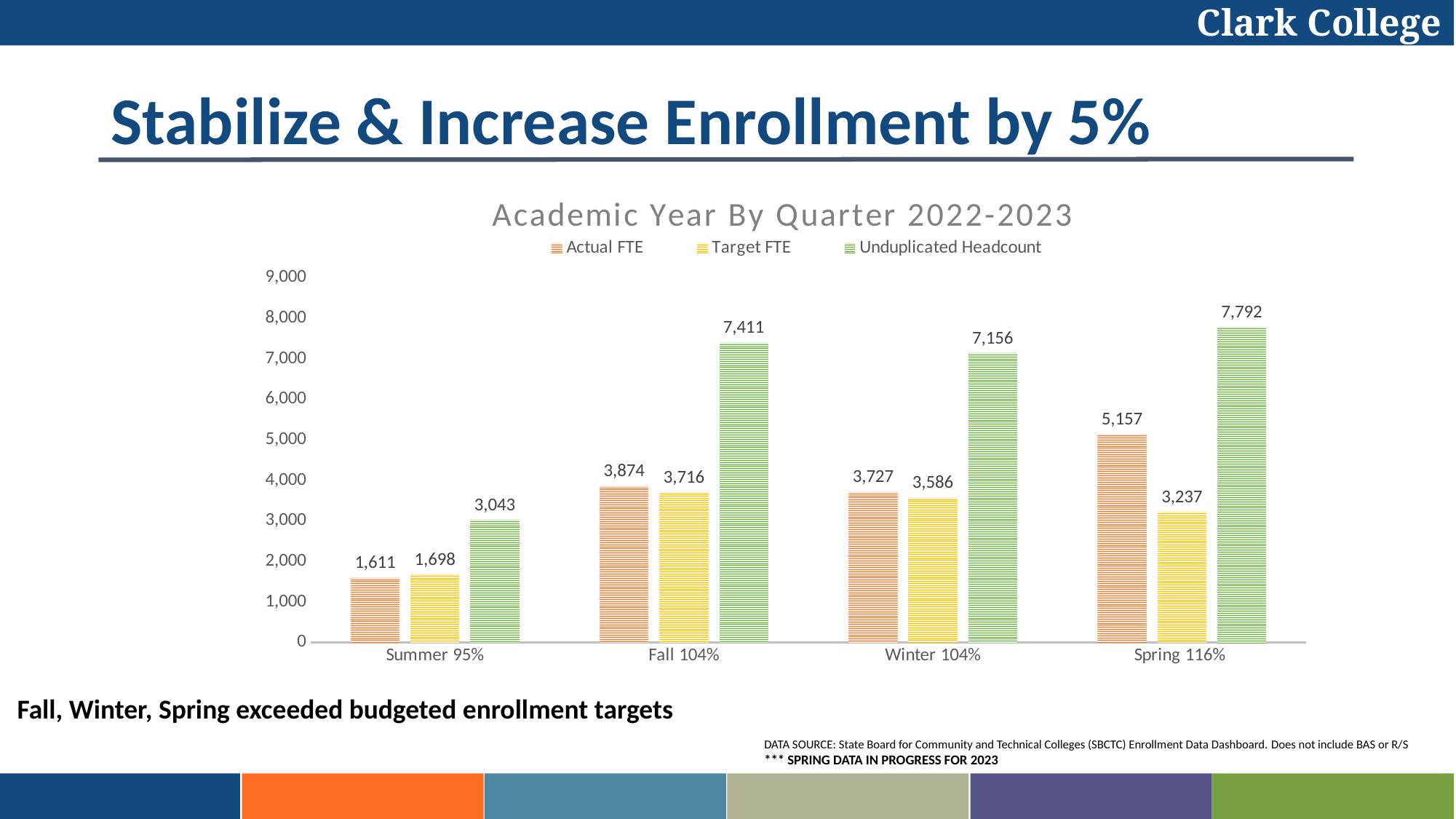
What kind of chart is shown on the slide? Bar chart Which quarter has the highest Unduplicated Headcount? Spring 116% How many series does the legend list? 3 What is the title of the chart? Academic Year By Quarter 2022-2023 What is the Unduplicated Headcount for Spring 116%? 7,792 What is the Actual FTE value for Fall 104%? 3,874 Which quarter has the lowest Actual FTE? Summer 95% Is the Unduplicated Headcount for Fall 104% greater or less than 7,000? greater What is the difference between Actual FTE and Target FTE for Spring 116%? 1,920 What is the Target FTE for Summer 95%? 1,698 Which is larger for Winter 104%: Actual FTE or Target FTE? Actual FTE How many quarters are shown on the x axis? 4